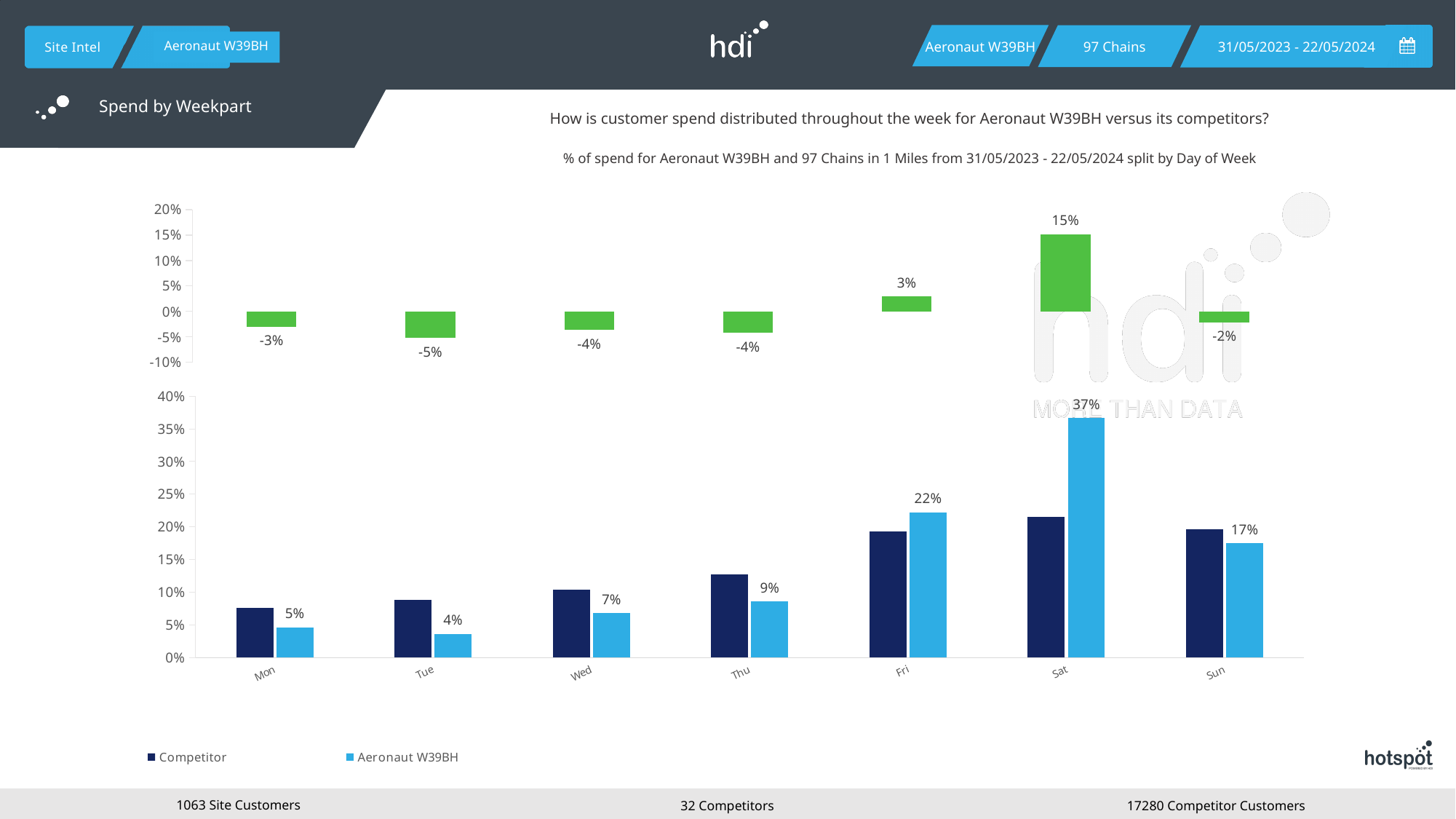
In the bottom chart, on Fri, which is larger: the Competitor value or the Aeronaut W39BH value? Aeronaut W39BH In the top chart, what is the value for Sat? 15% In the bottom chart, what is the Aeronaut W39BH value for Sat? 37% In the bottom chart, how many days are shown on the x axis? 7 In the top chart, what is the value for Tue? -5% In the bottom chart, is the Competitor value for Thu greater or less than 10%? greater In the bottom chart, what is the Aeronaut W39BH value for Tue? 4% In the bottom chart, how many series does the legend list? 2 In the top chart, which day has the lowest value? Tue In the bottom chart, what is the difference between the Aeronaut W39BH values for Fri and Sun? 5% In the bottom chart, which day has the lowest Aeronaut W39BH value? Tue In the bottom chart, which day has the highest Aeronaut W39BH value? Sat